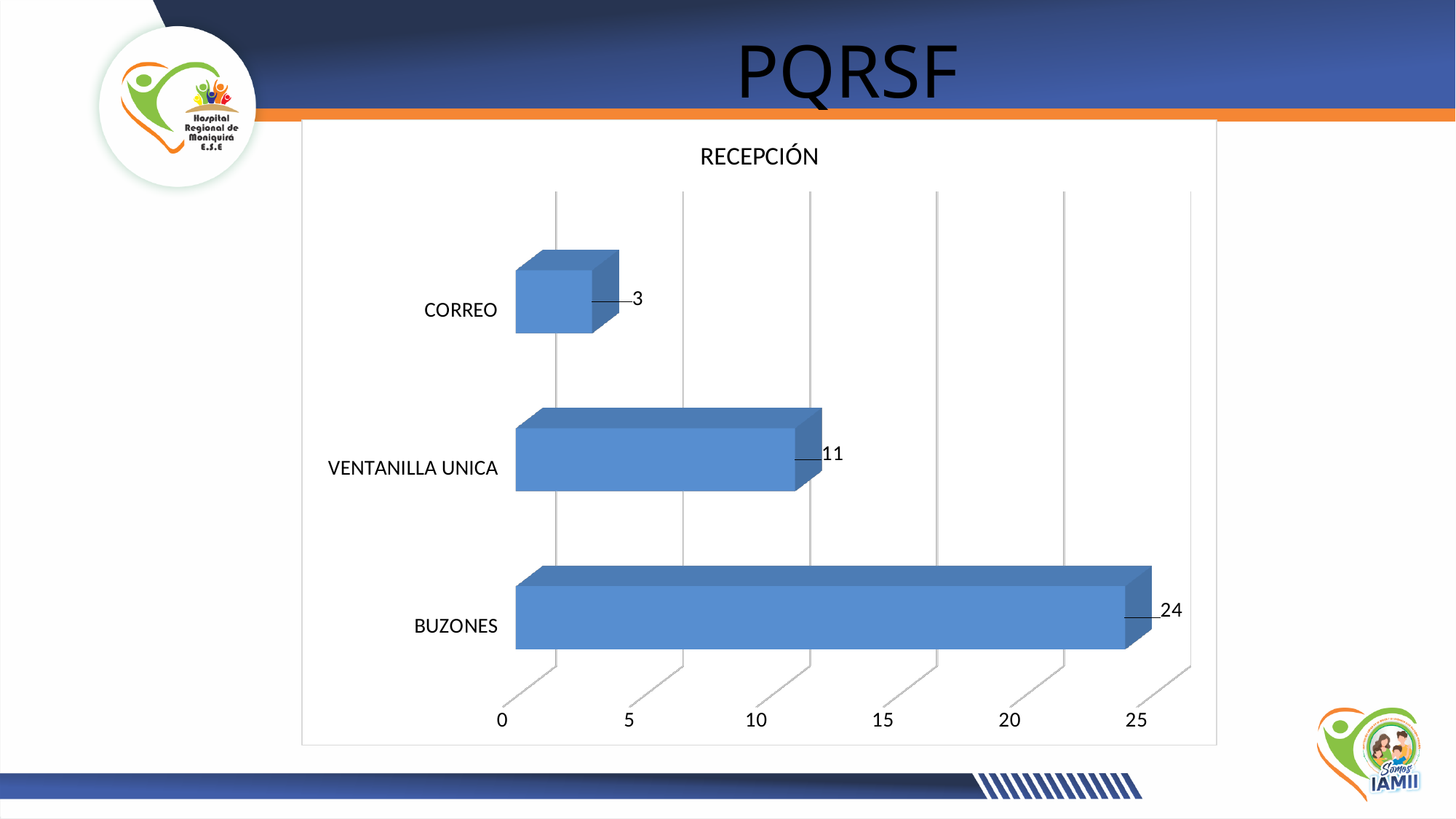
What is the value for VENTANILLA UNICA? 11 Which category has the lowest value? CORREO What is the value for CORREO? 3 What is the difference between the values for VENTANILLA UNICA and CORREO? 8 What is the title of the chart? RECEPCIÓN What is the value for BUZONES? 24 How many categories are shown in the chart? 3 Which is larger, the value for VENTANILLA UNICA or the value for CORREO? VENTANILLA UNICA What is the difference between the values for BUZONES and VENTANILLA UNICA? 13 What kind of chart is shown on the slide? bar chart Which category has the highest value? BUZONES Is the value for BUZONES greater or less than 20? greater